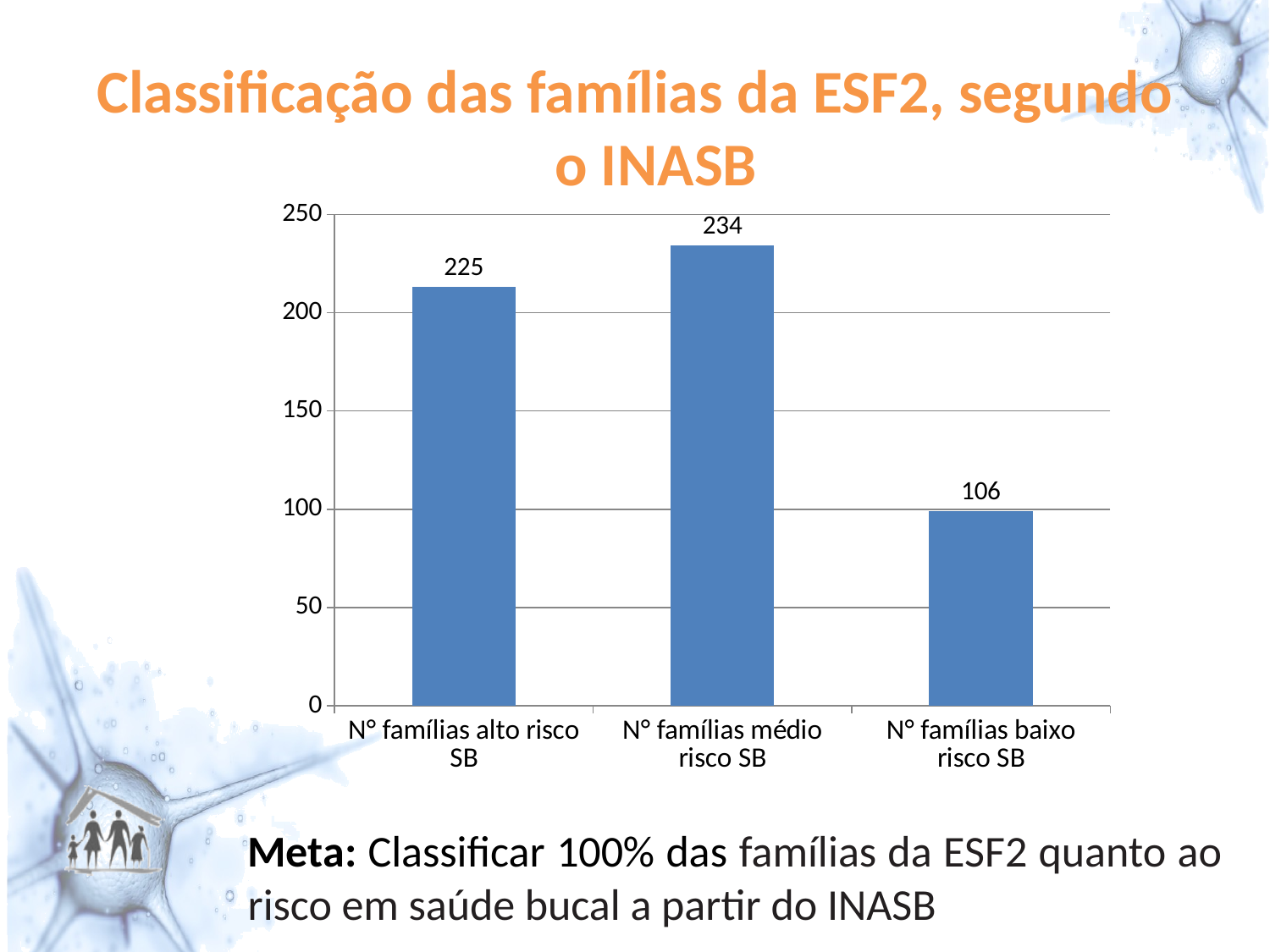
Is the value for N° famílias baixo risco SB greater or less than 150? less What is the value for N° famílias alto risco SB? 225 What is the difference between the values for N° famílias médio risco SB and N° famílias baixo risco SB? 128 Which category has the lowest value? N° famílias baixo risco SB How many categories are shown in the chart? 3 What is the value for N° famílias baixo risco SB? 106 What is the value for N° famílias médio risco SB? 234 What kind of chart is shown on the slide? bar chart What is the title of the chart on the slide? Classificação das famílias da ESF2, segundo o INASB Which is larger, the value for N° famílias alto risco SB or N° famílias baixo risco SB? N° famílias alto risco SB What is the difference between the values for N° famílias alto risco SB and N° famílias baixo risco SB? 119 Which category has the highest value? N° famílias médio risco SB